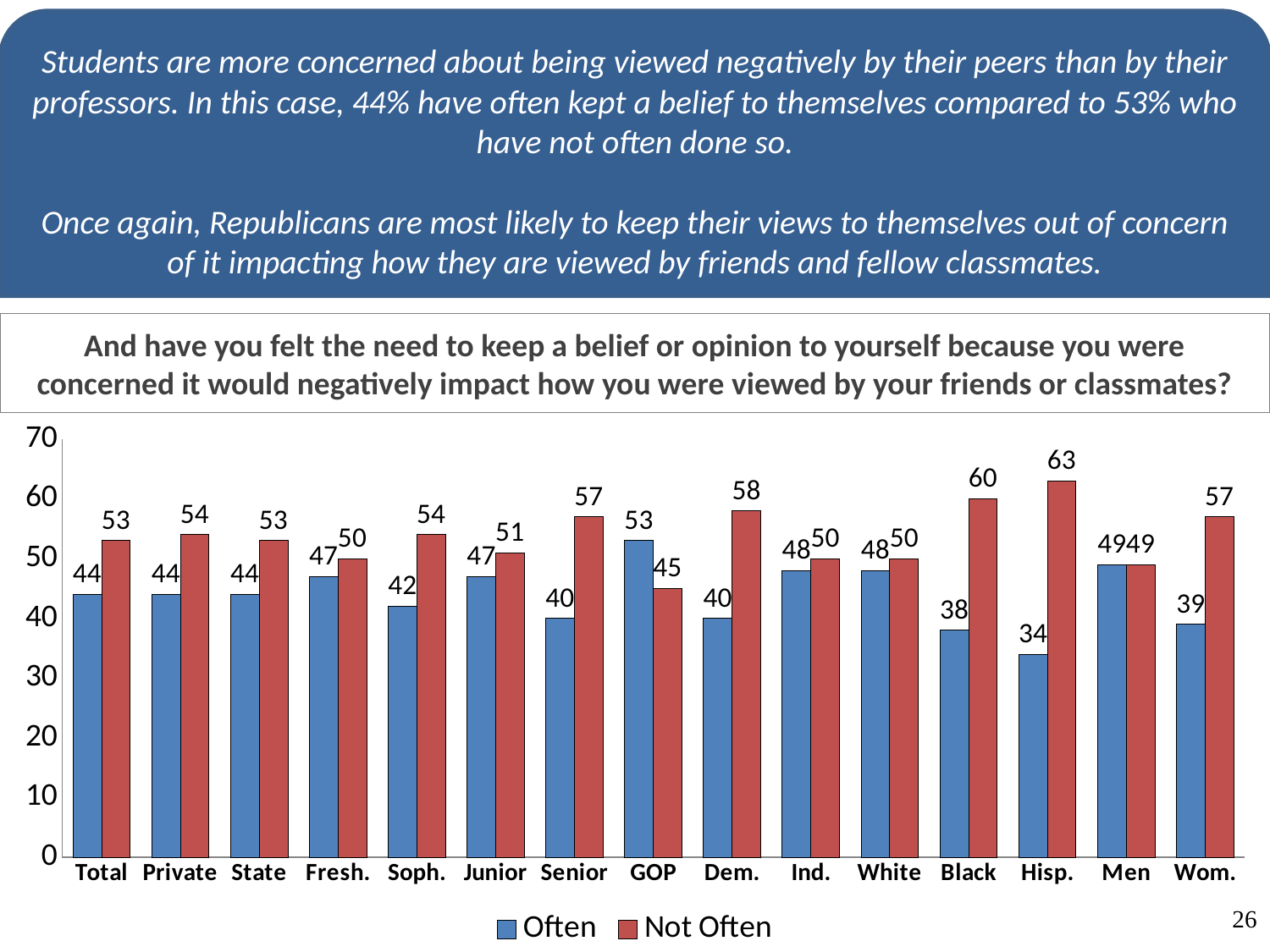
What colour are the 'Not Often' bars? red What is the difference between the 'Not Often' and 'Often' values for Senior? 17 What is the 'Often' value for Total? 44 Which category has the lowest 'Often' value? Hisp. Which category has the highest 'Not Often' value? Hisp. How many categories are shown on the x axis? 15 How many series does the legend list? 2 Is the 'Not Often' value for Black greater or less than 50? greater What is the 'Often' value for GOP? 53 What is the 'Not Often' value for Hisp.? 63 Which is larger for GOP, the 'Often' value or the 'Not Often' value? Often What kind of chart is shown on the slide? bar chart